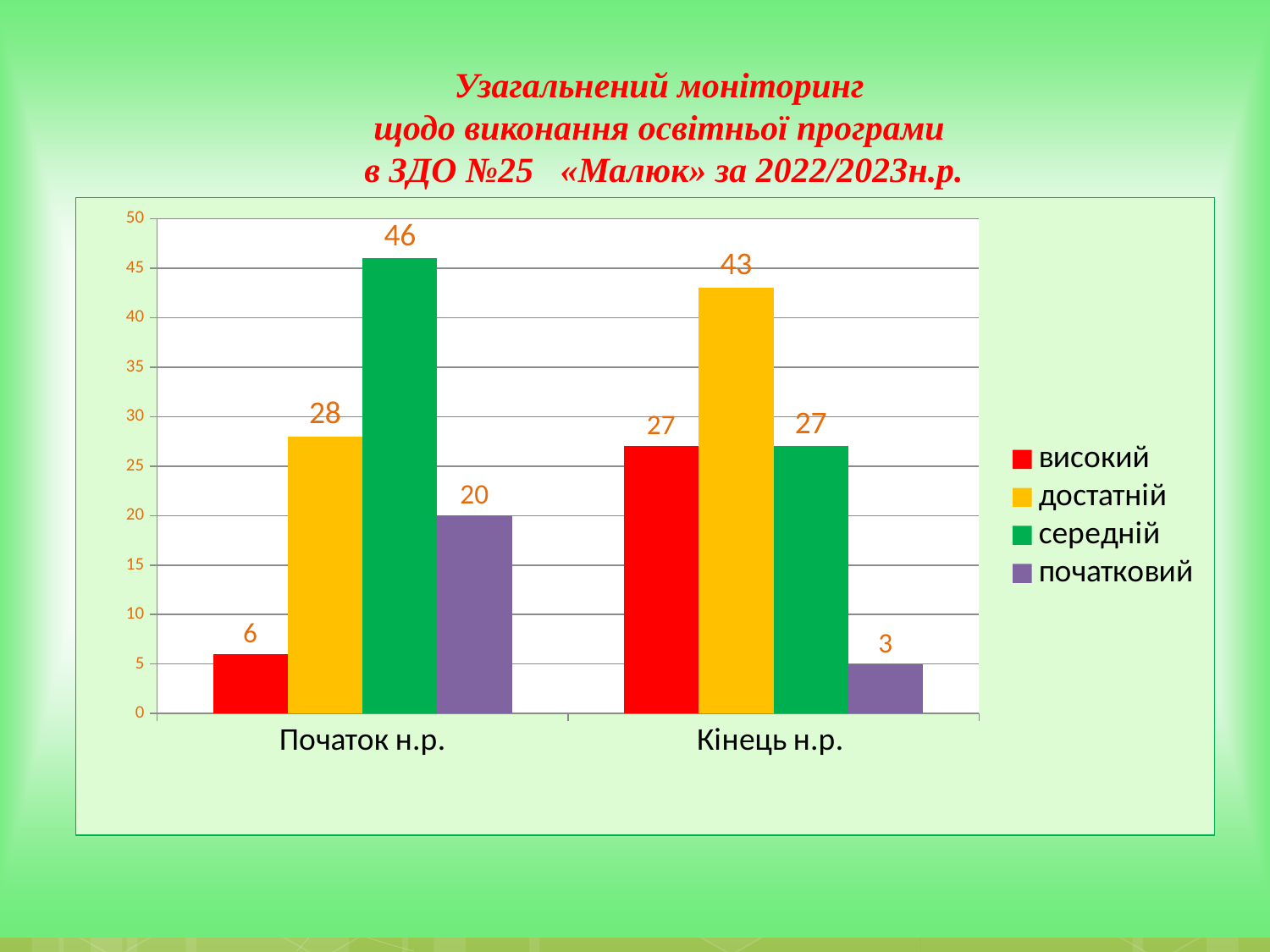
What is the value for початковий at Початок н.р.? 20 What kind of chart is shown on the slide? bar chart How many categories are shown on the x axis? 2 What is the value for середній at Кінець н.р.? 27 How many series does the legend list? 4 What is the value for достатній at Кінець н.р.? 43 What is the value for високий at Початок н.р.? 6 Which series has the lowest value at Кінець н.р.? початковий What is the difference between the середній values at Початок н.р. and Кінець н.р.? 19 Which series has the highest value at Початок н.р.? середній Does the value for початковий rise or fall from Початок н.р. to Кінець н.р.? fall Which is larger: високий at Початок н.р. or високий at Кінець н.р.? високий at Кінець н.р.